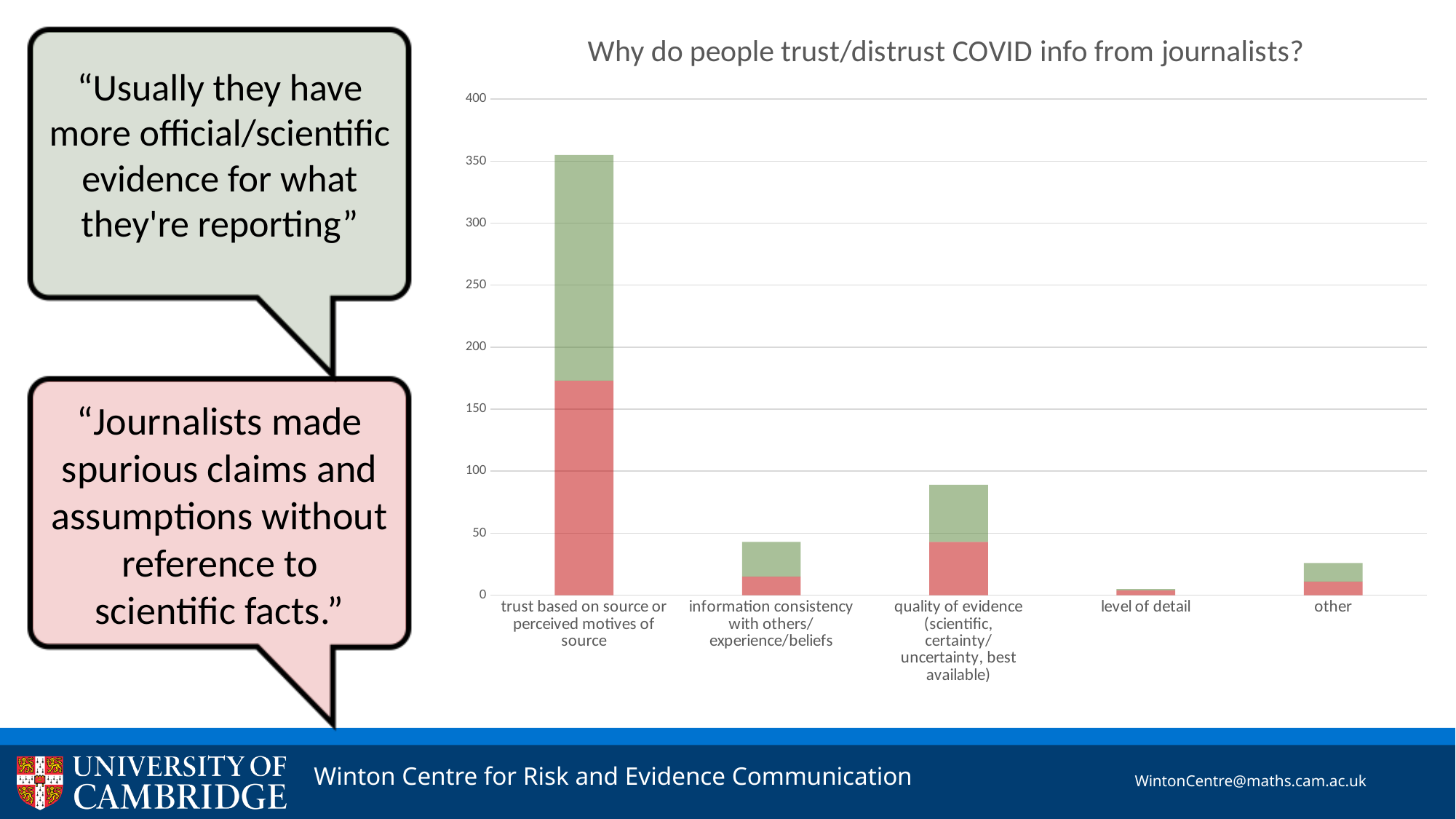
Is the red segment of the 'trust based on source or perceived motives of source' bar greater or less than 150? greater Is the total bar for 'information consistency with others/experience/beliefs' greater or less than 50? less How many categories are shown on the x axis of the chart? 5 What is the title of the chart? Why do people trust/distrust COVID info from journalists? Which category has the shortest bar? level of detail Which bar is taller: 'quality of evidence (scientific, certainty/uncertainty, best available)' or 'information consistency with others/experience/beliefs'? quality of evidence (scientific, certainty/uncertainty, best available) Which category has the tallest bar? trust based on source or perceived motives of source Which bar is taller: 'other' or 'level of detail'? other Is the total bar for 'trust based on source or perceived motives of source' greater or less than 300? greater What kind of chart is shown on the slide? Stacked bar chart